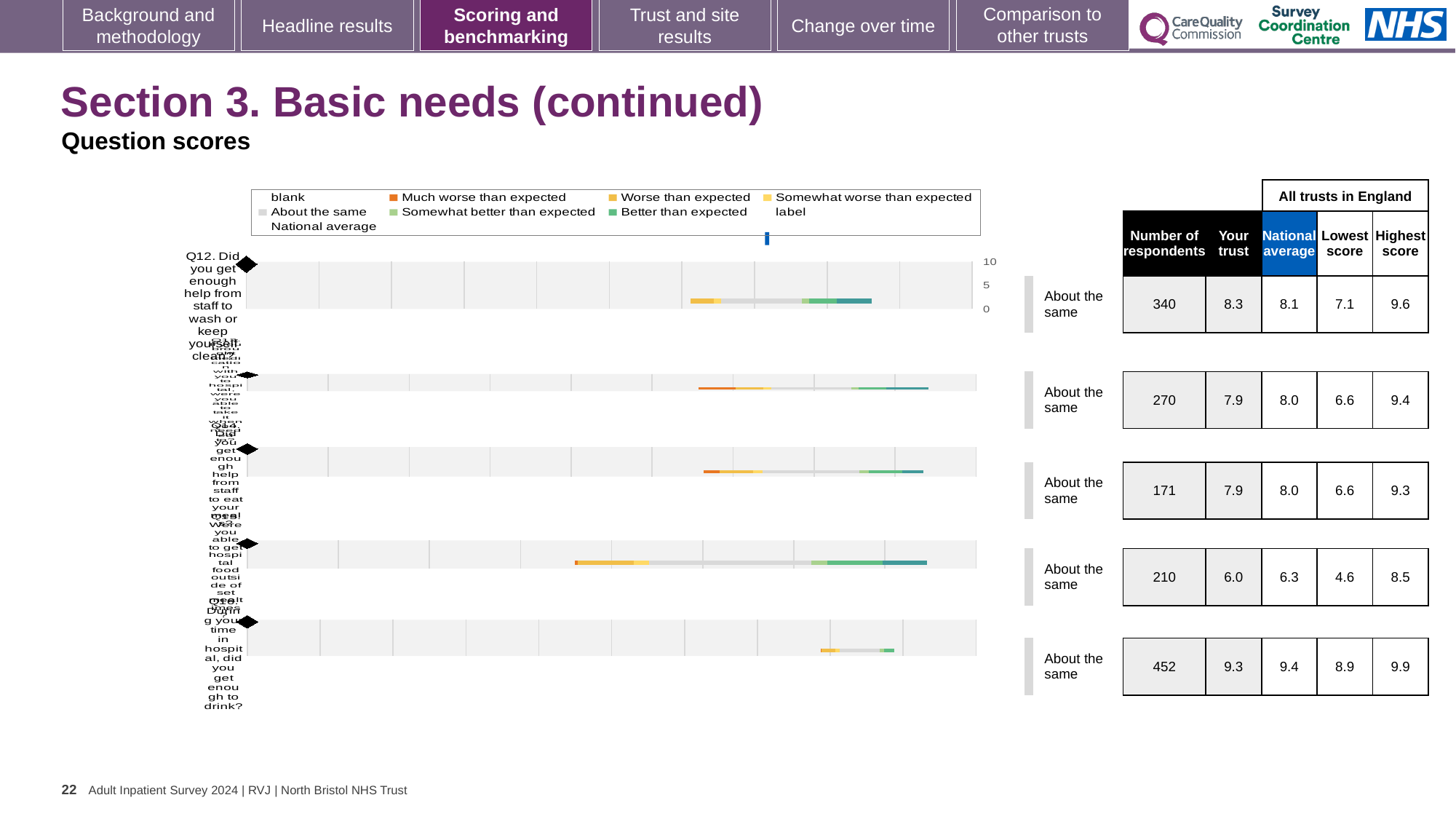
What colour does the legend use for 'Much worse than expected'? orange What is the highest score among all trusts in England for Q12 (Did you get enough help from staff to wash or keep yourself clean?)? 9.6 What is the 'Your trust' score for Q12 (Did you get enough help from staff to wash or keep yourself clean?)? 8.3 What is the national average score for Q12 (Did you get enough help from staff to wash or keep yourself clean?)? 8.1 What type of chart is used to show the question scores on this slide? bar chart Which question row has the highest number of respondents? the bottom (fifth) row, with 452 How many respondents are listed for Q12 (Did you get enough help from staff to wash or keep yourself clean?)? 340 For Q12, which is larger: the 'Your trust' score or the national average? Your trust For Q12, what is the difference between the highest score (9.6) and the lowest score (7.1) across all trusts in England? 2.5 How many question rows (bars) are plotted in the chart? 5 What is the 'Your trust' score for the bottom (fifth) question row in the chart? 9.3 What benchmark category is shown for Q12 (Did you get enough help from staff to wash or keep yourself clean?)? About the same